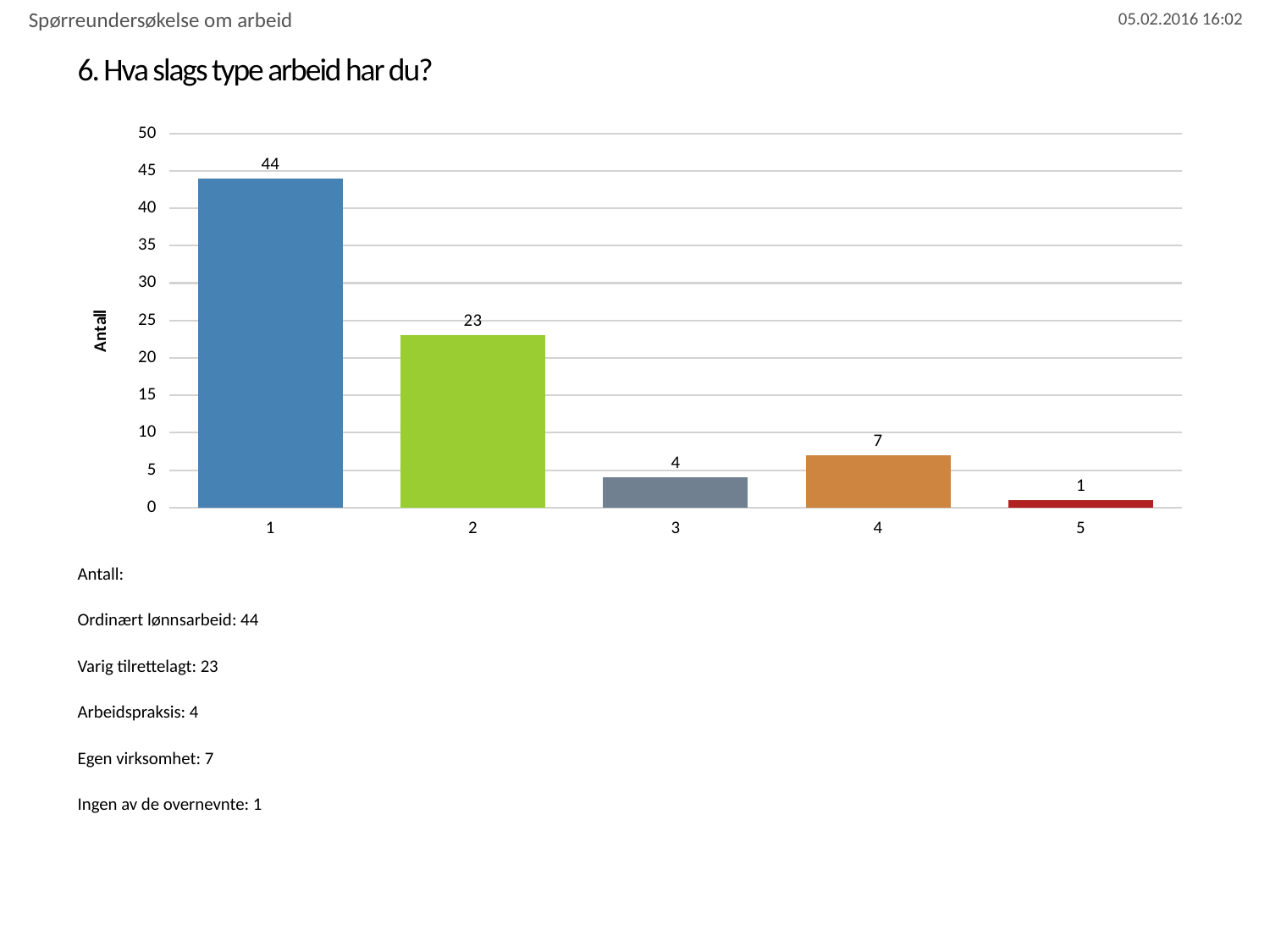
Which category has the highest value? 1 What is the value for category 4? 7 How many categories are shown on the x axis? 5 What is the value for category 1? 44 Which is larger, the value for category 3 or category 4? category 4 What is the label of the y axis? Antall What is the value for category 5? 1 What is the difference between the values for category 1 and category 2? 21 Is the value for category 2 greater or less than 20? greater Which category has the lowest value? 5 What is the difference between the values for category 4 and category 3? 3 What kind of chart is shown on the slide? bar chart